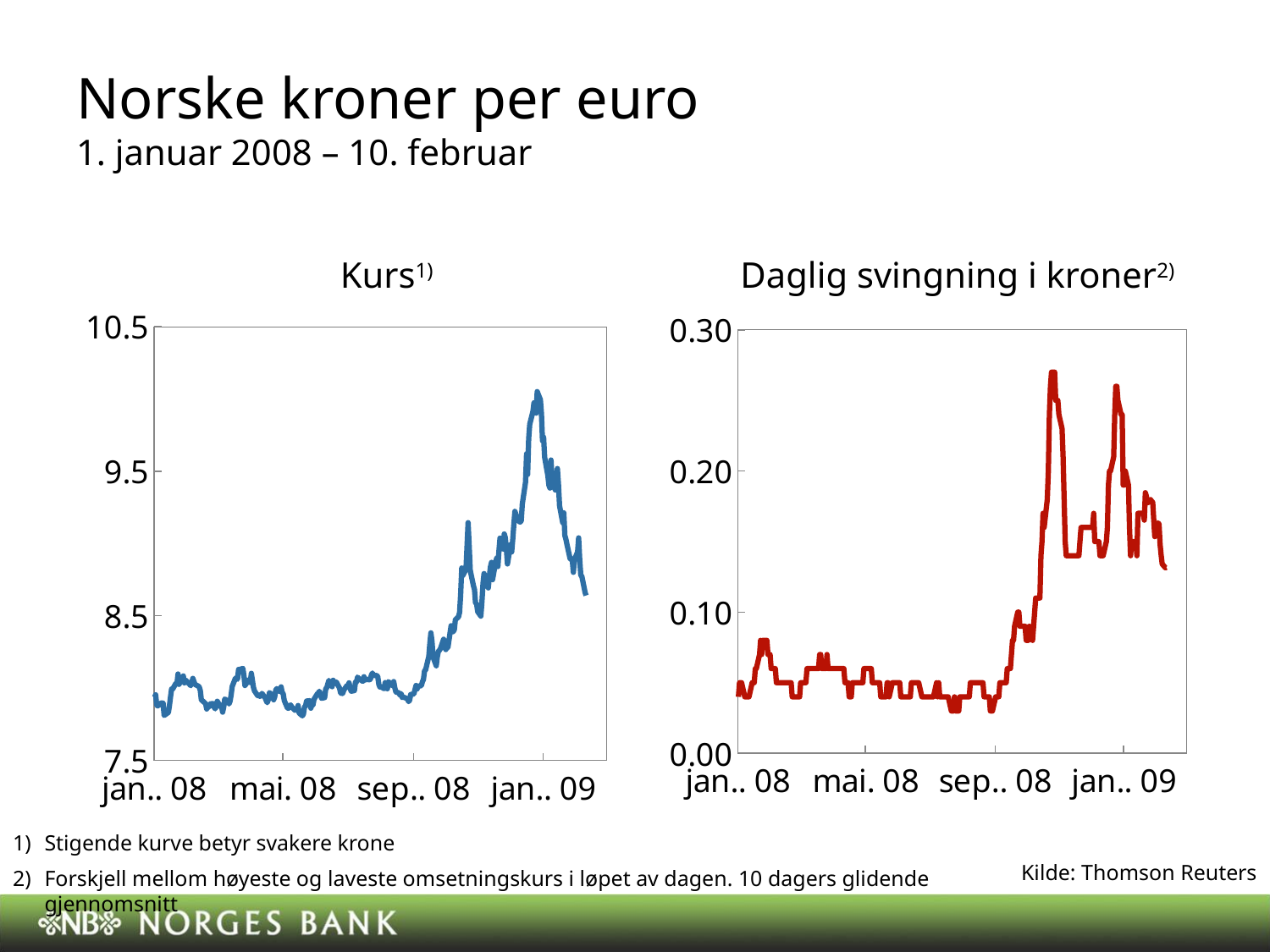
How many charts are shown on the slide? 2 In the left chart "Kurs", is the value at mai. 08 greater or less than 8.5? less In the right chart "Daglig svingning i kroner", is the value at jan. 09 higher or lower than the value at jan. 08? higher In the right chart "Daglig svingning i kroner", is the highest value reached by the line greater or less than 0.20? greater In the left chart "Kurs", does the line rise or fall between sep. 08 and jan. 09? rise What kind of chart is the left chart titled "Kurs"? line chart In the left chart "Kurs", is the highest value reached by the line greater or less than 9.5? greater What kind of chart is the right chart titled "Daglig svingning i kroner"? line chart What is the title of the right chart? Daglig svingning i kroner